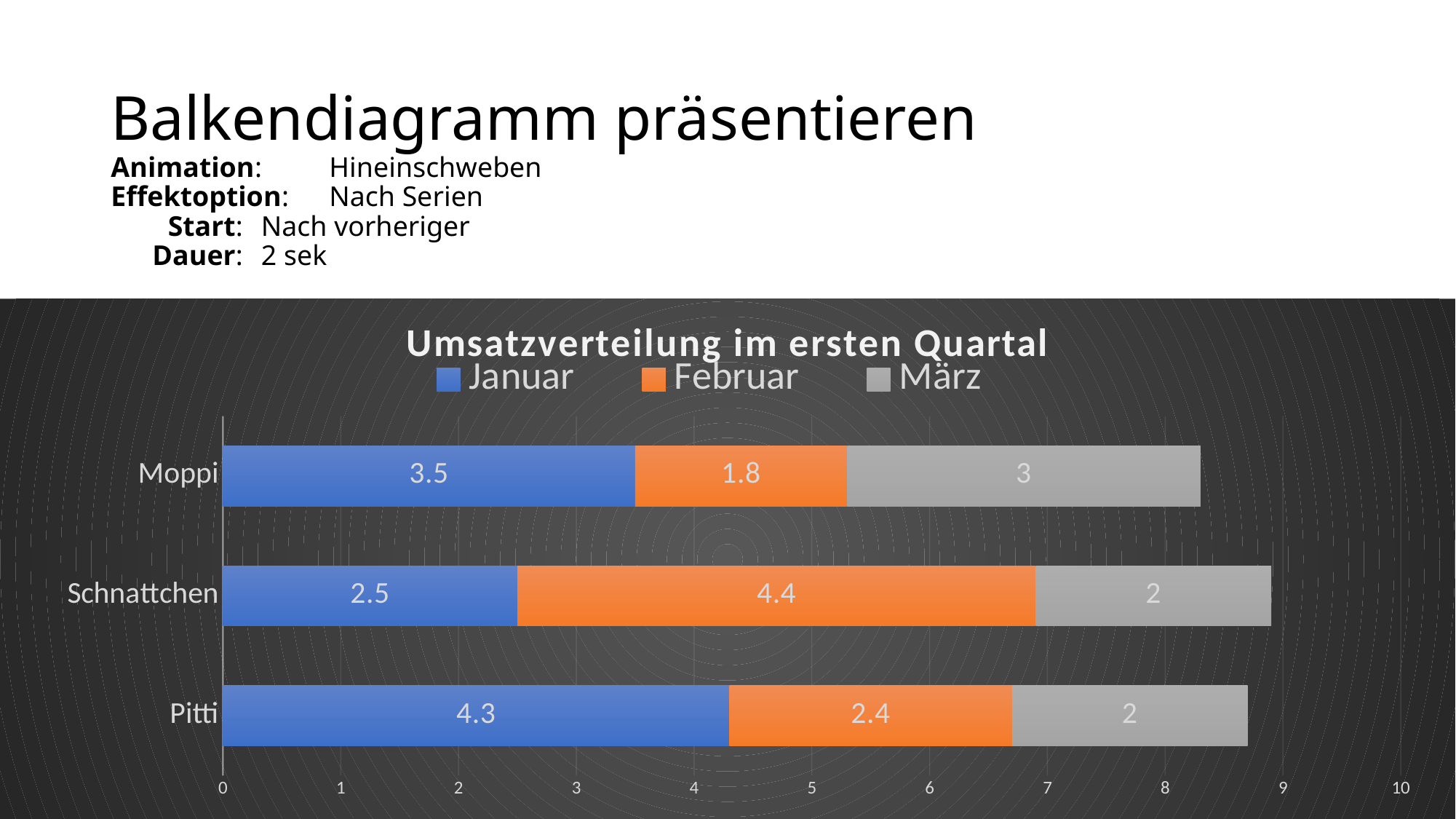
How many categories are shown on the vertical axis? 3 What is the total of the stacked bar for Moppi? 8.3 What type of chart is shown on the slide? Stacked bar chart What is the total of the stacked bar for Schnattchen? 8.9 What is the März value for Pitti? 2 Which category has the lowest Januar value? Schnattchen How many series does the legend list? 3 What is the difference between the Januar values for Pitti and Moppi? 0.8 What is the Januar value for Moppi in the chart? 3.5 Which category has the highest Februar value? Schnattchen What is the Februar value for Schnattchen? 4.4 Which is larger: the März value for Moppi or the März value for Schnattchen? Moppi